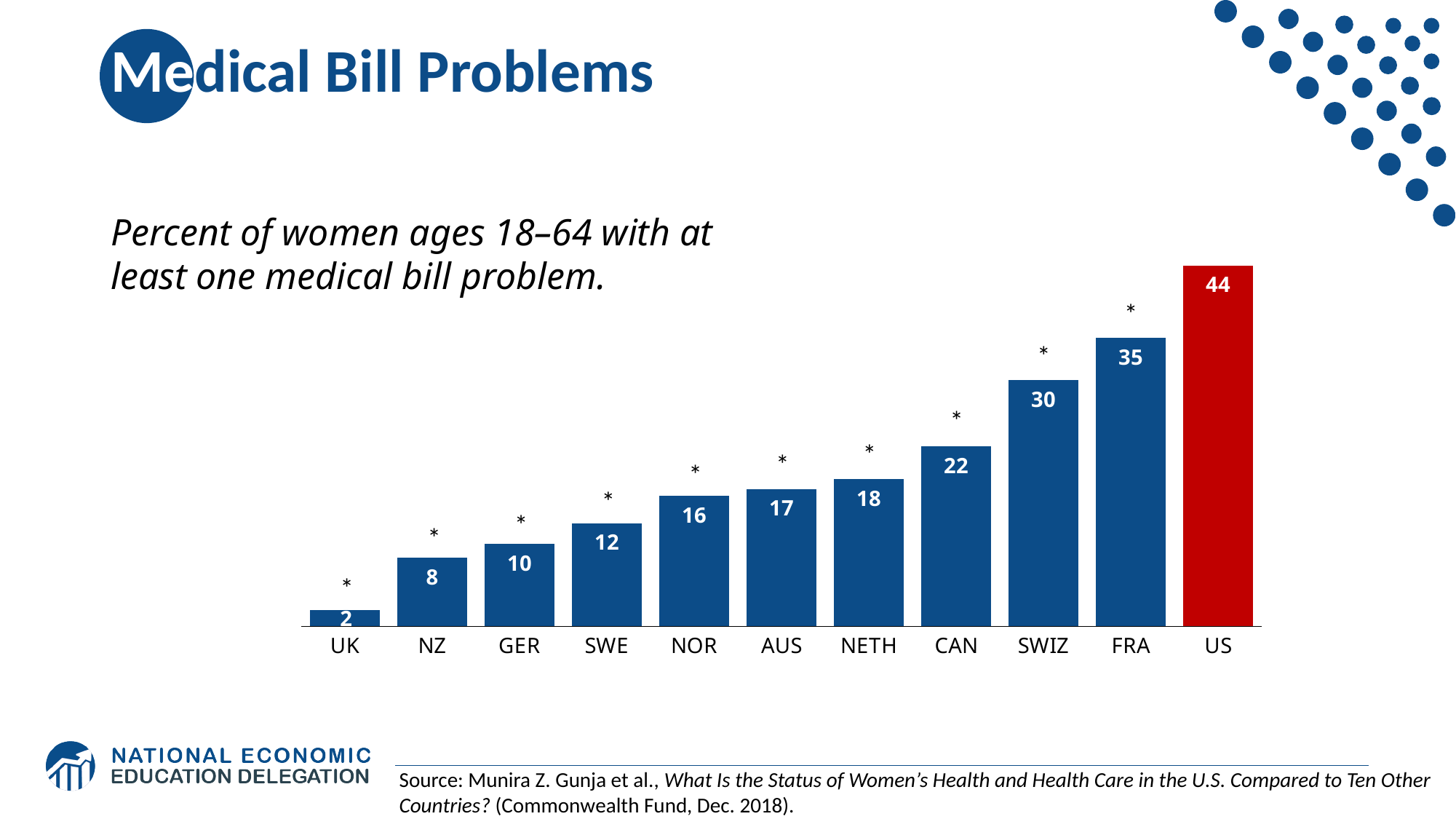
What is the difference between the values for SWIZ and NZ? 22 Which country has the highest value? US What is the value for the US? 44 What is the value for CAN? 22 Do the values rise or fall from left to right along the x axis? Rise How many countries are shown on the chart? 11 Which bar is coloured red rather than blue? US What kind of chart is this? Bar chart Which country has the lowest value? UK Which has a larger value, NOR or NETH? NETH What is the value for SWE? 12 What is the difference between the values for the US and FRA? 9